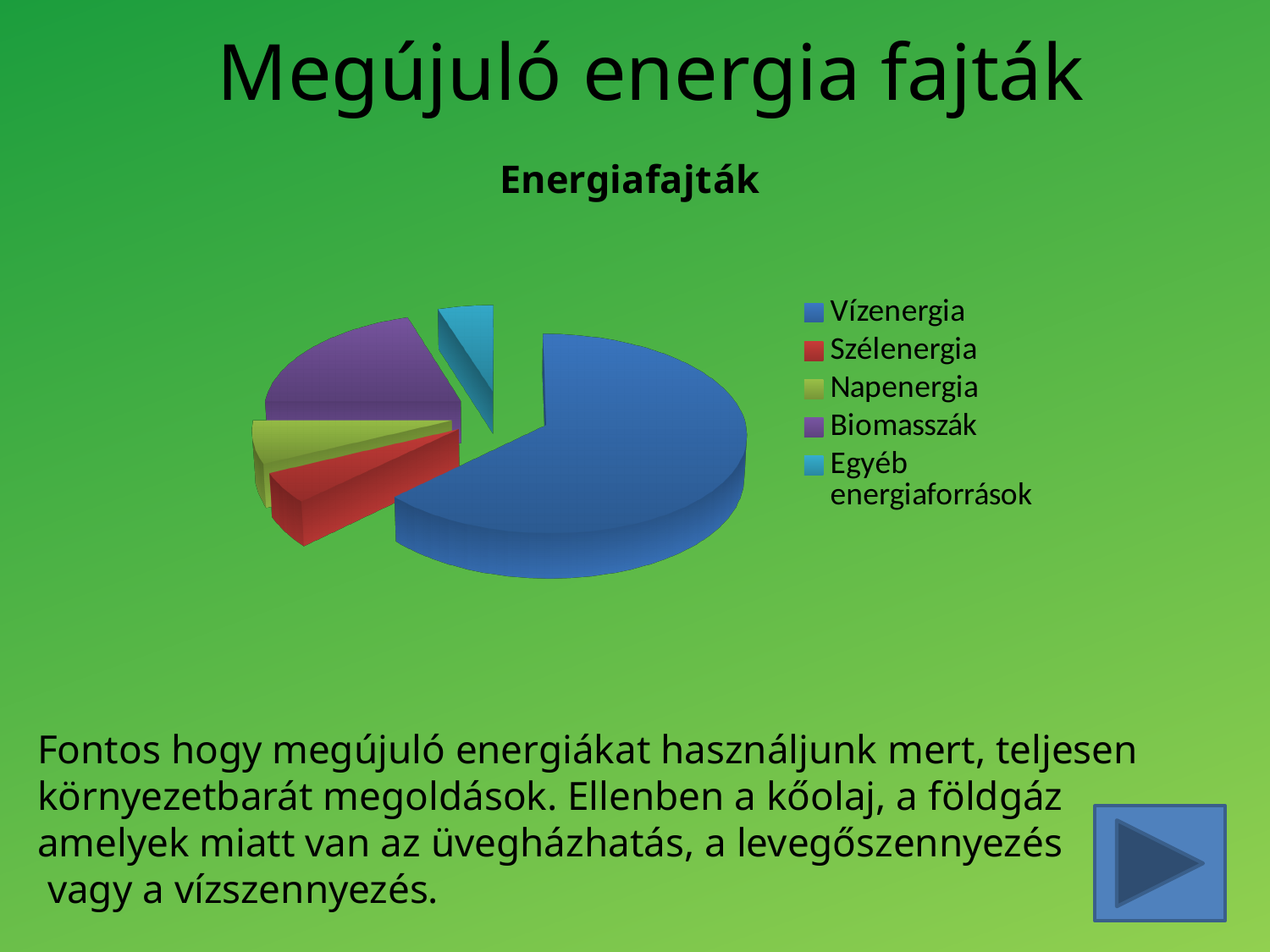
Which slice is larger, Biomasszák or Napenergia? Biomasszák What colour is the Vízenergia slice in the pie chart? Blue How many slices does the pie chart have? 5 How many entries does the chart legend list? 5 Which slice is larger, Vízenergia or Biomasszák? Vízenergia Which slice is larger, Biomasszák or Egyéb energiaforrások? Biomasszák What is the title of the chart? Energiafajták Which category has the largest slice of the pie? Vízenergia What kind of chart is shown on the slide? Pie chart